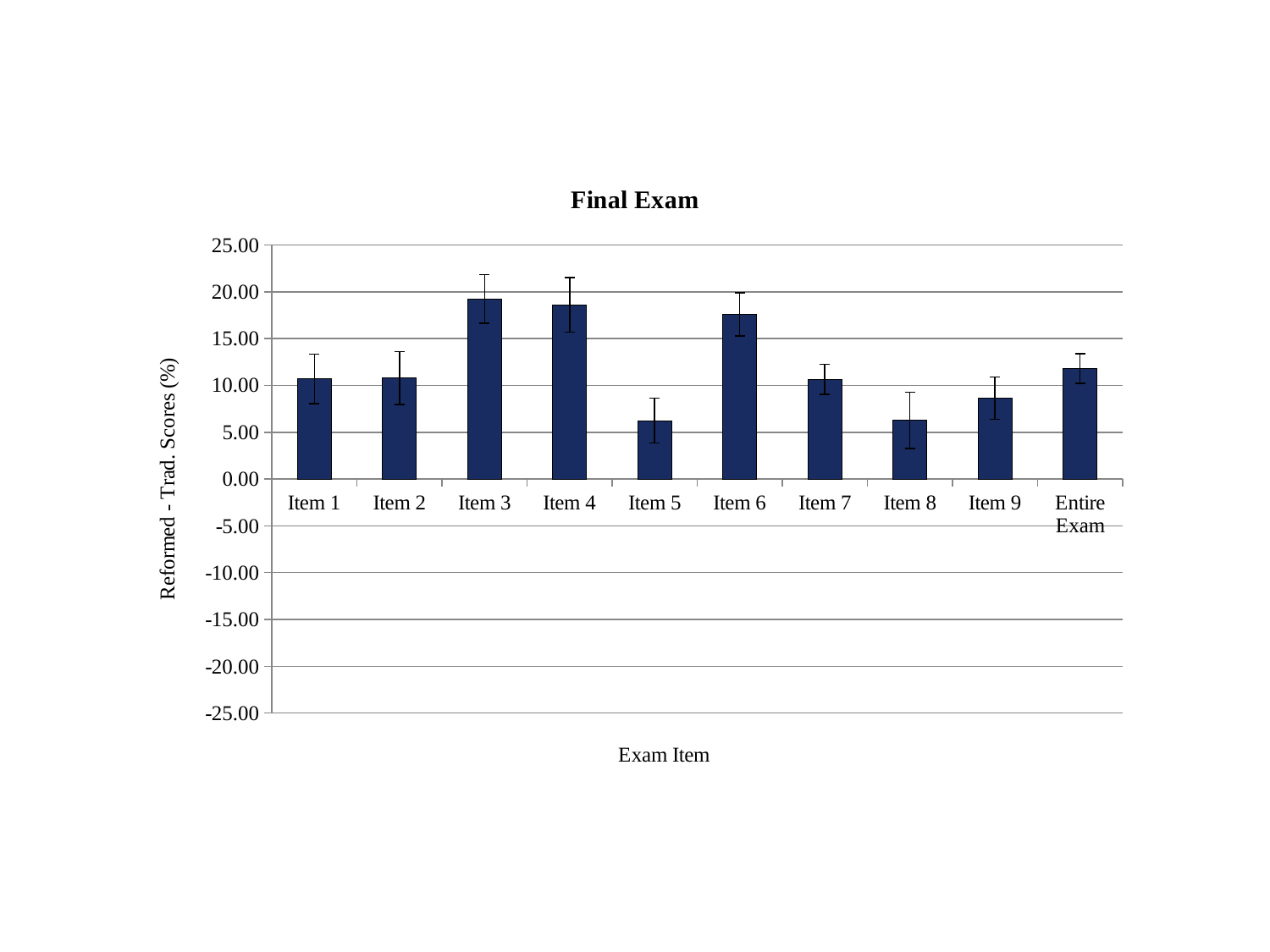
Which has the larger value, Item 6 or Item 9? Item 6 Is the value for Item 5 greater or less than 10.00? less What is the title of the chart? Final Exam Is the value for Entire Exam greater or less than 10.00? greater How many categories are plotted along the x axis? 10 Is the value for Item 4 greater or less than 15.00? greater Which has the larger value, Item 3 or Item 5? Item 3 What kind of chart is shown on the slide? bar chart What is the label of the x axis? Exam Item